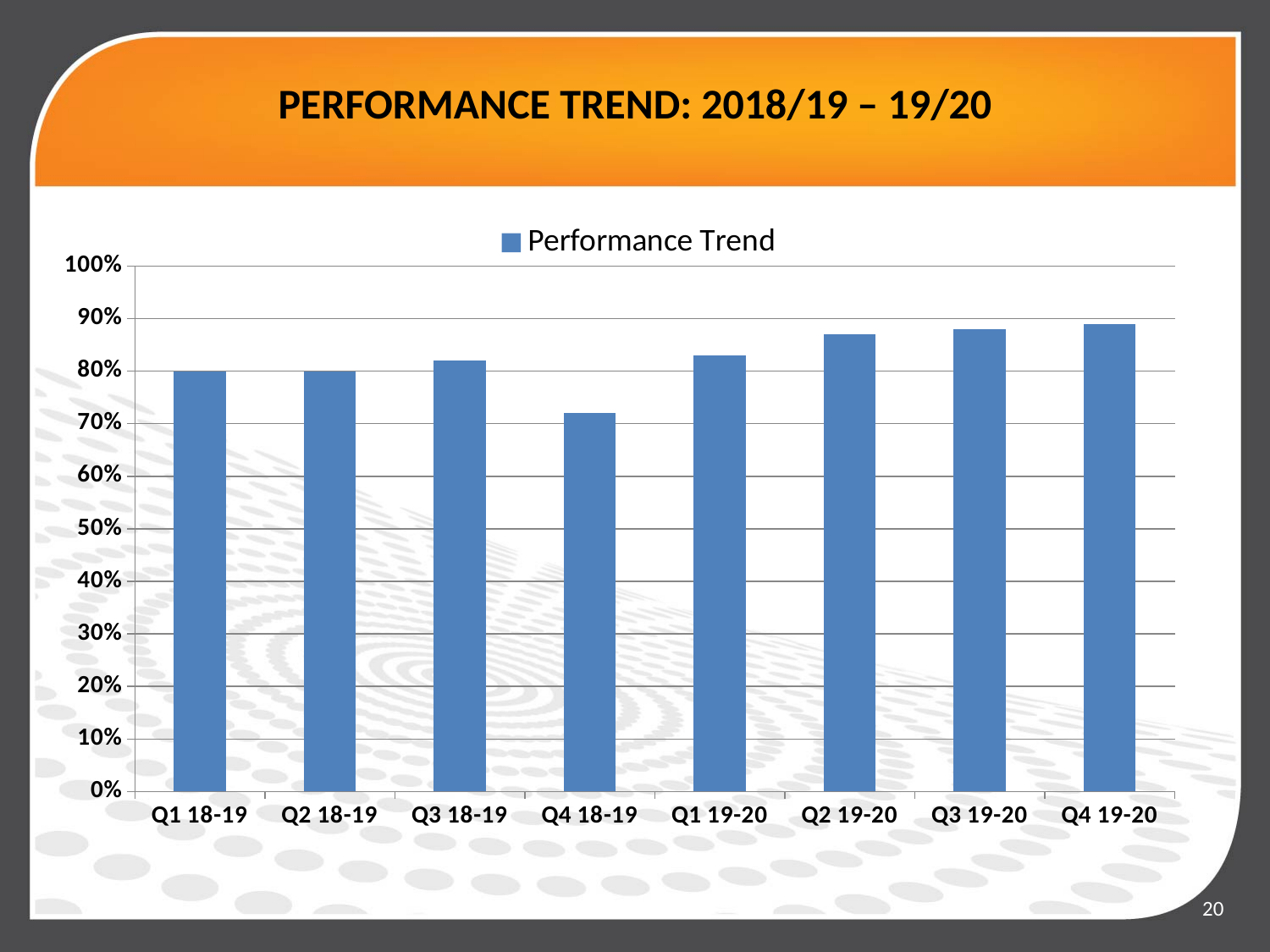
Is the value for Q4 18-19 greater or less than 70%? greater What kind of chart is shown on the slide? bar chart Which is larger, the value for Q3 18-19 or the value for Q2 19-20? Q2 19-20 Is the value for Q4 18-19 greater or less than 80%? less Which quarter has the lowest value in the chart? Q4 18-19 Do the values rise or fall across the four quarters of 19-20, from Q1 19-20 to Q4 19-20? rise What is the name of the series shown in the chart's legend? Performance Trend How many quarters are plotted on the x axis of the chart? 8 Which is larger, the value for Q4 18-19 or the value for Q1 19-20? Q1 19-20 Is the value for Q2 19-20 greater or less than 80%? greater How many series does the chart's legend list? 1